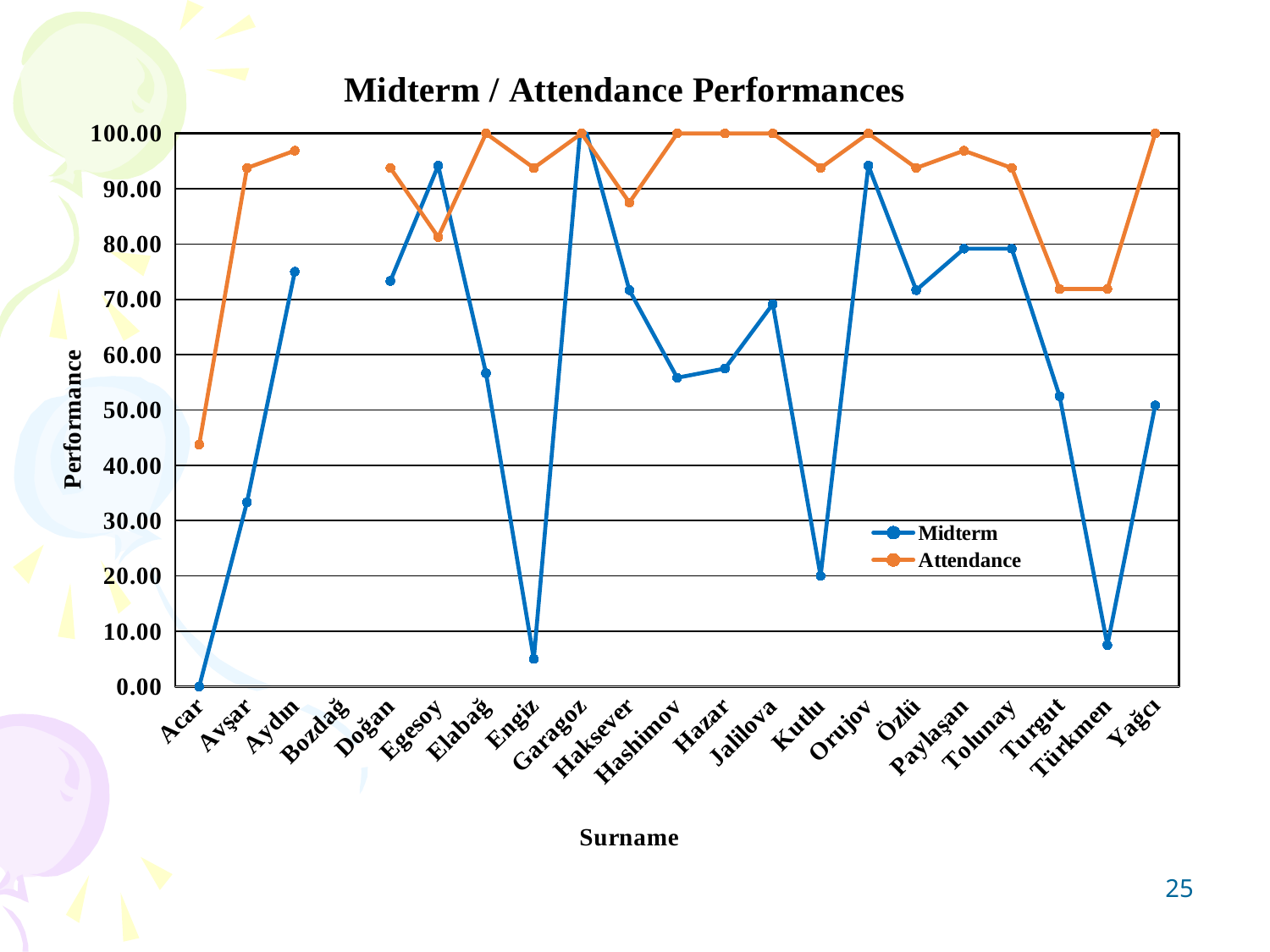
What is the Attendance value for Hazar? 100.00 Is the Attendance value for Acar greater or less than 40.00? greater What is the title of the chart? Midterm / Attendance Performances What is the Midterm value for Acar? 0.00 How many series does the legend list? 2 Is the Midterm value for Engiz greater or less than 10.00? less What is the label of the vertical axis? Performance Which is larger, the Midterm value for Orujov or the Midterm value for Kutlu? Orujov How many surnames are listed along the x axis? 21 Which surname has the highest Midterm value? Garagoz Which surname has the lowest Midterm value? Acar What kind of chart is shown on the slide? line chart